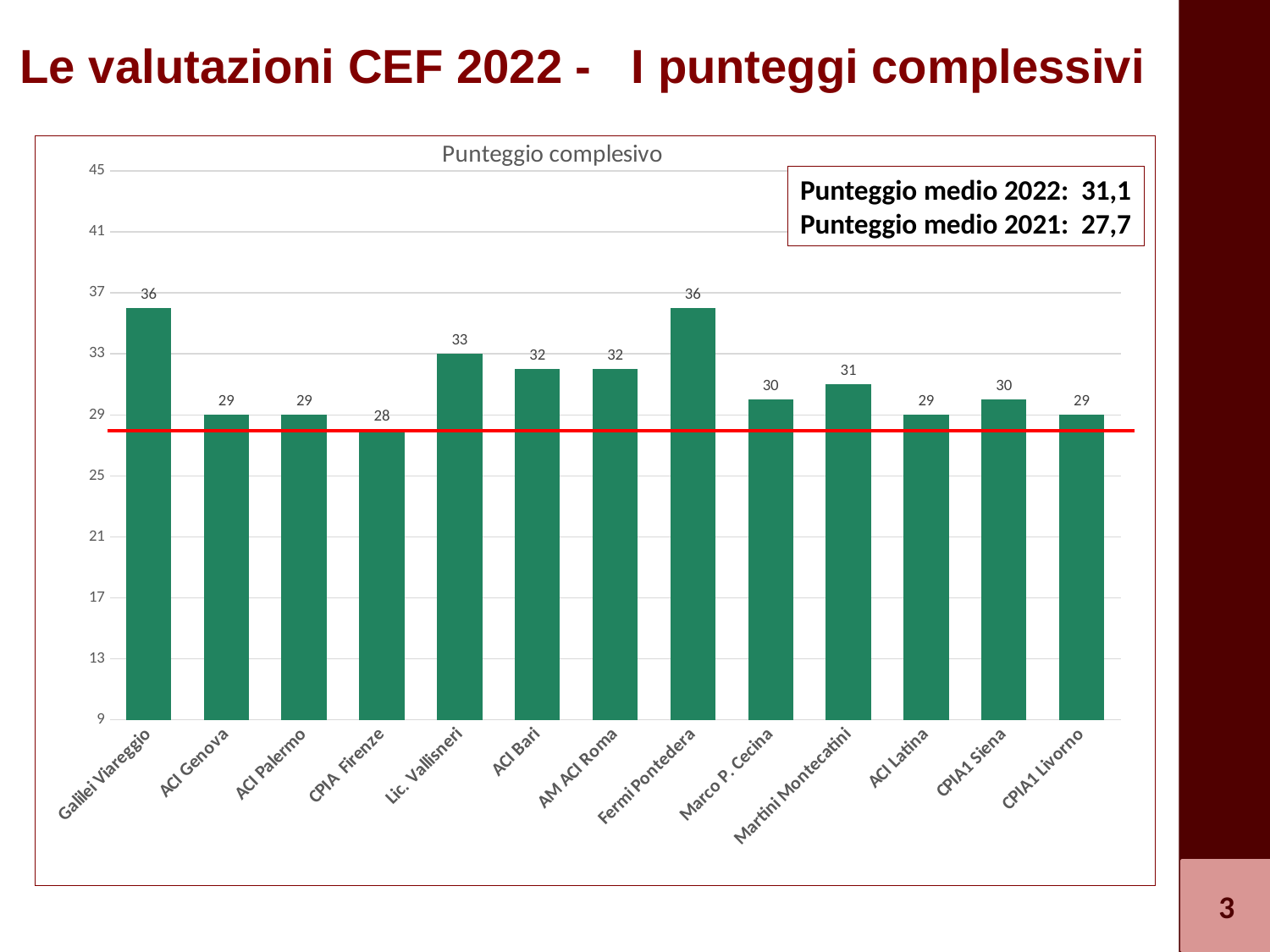
How many categories are shown on the x axis? 13 What is the value for Martini Montecatini? 31 What is the value for Marco P. Cecina? 30 Which category has the lowest value? CPIA Firenze Which categories share the highest value? Galilei Viareggio and Fermi Pontedera What is the title of the chart? Punteggio complesivo What is the value for CPIA Firenze? 28 Which is larger, the value for Martini Montecatini or the value for ACI Latina? Martini Montecatini What is the value for Lic. Vallisneri? 33 What is the difference between the values for Galilei Viareggio and CPIA Firenze? 8 What is the difference between the values for Lic. Vallisneri and ACI Bari? 1 What kind of chart is this? Bar chart